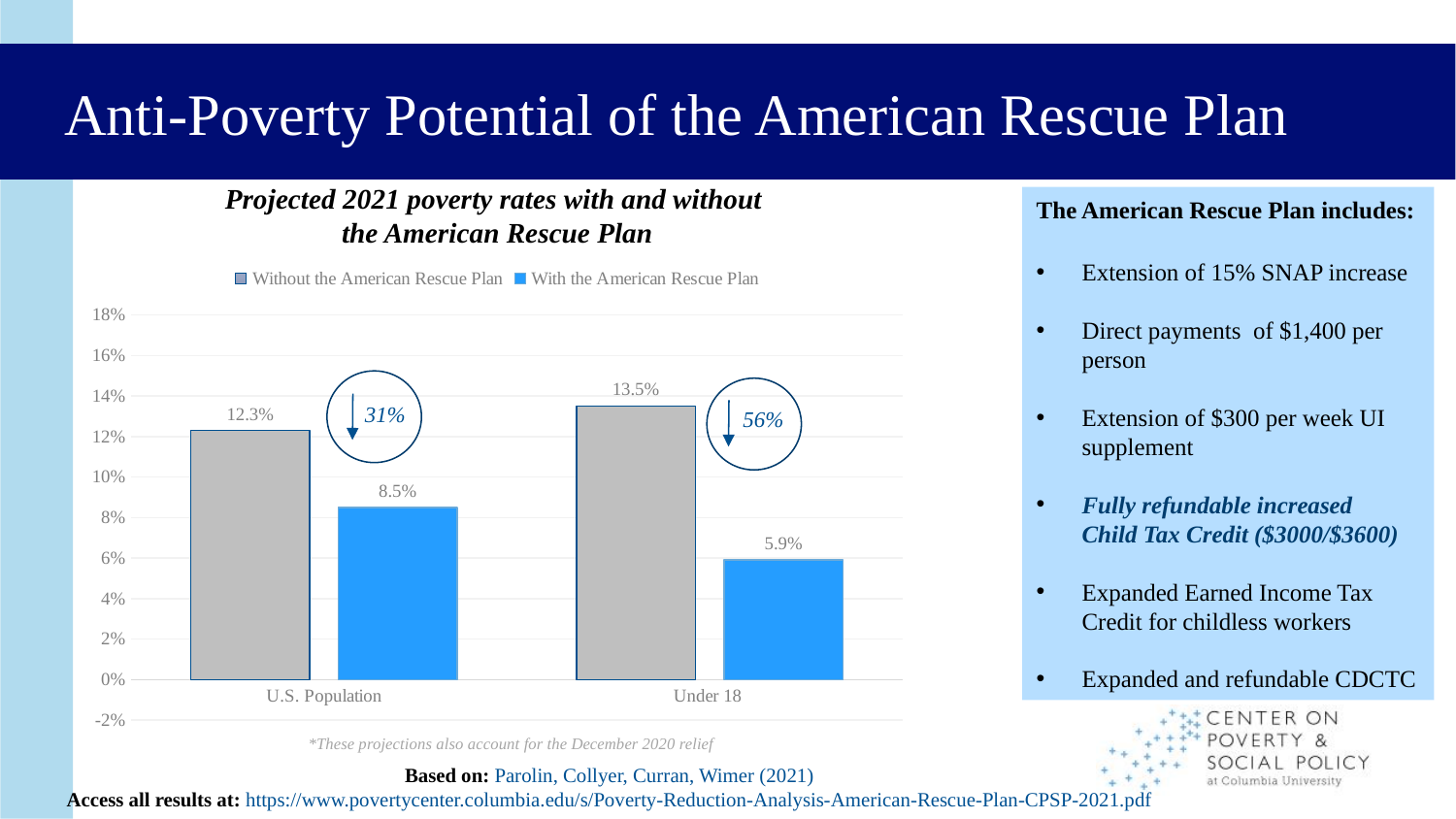
What is the projected 2021 poverty rate for Under 18 without the American Rescue Plan? 13.5% How many series does the chart legend list? 2 What kind of chart is shown on the slide? Bar chart What is the projected 2021 poverty rate for Under 18 with the American Rescue Plan? 5.9% How many categories are shown on the x axis of the chart? 2 Which category has the highest projected poverty rate without the American Rescue Plan? Under 18 What is the projected 2021 poverty rate for the U.S. Population with the American Rescue Plan? 8.5% What is the difference between the Under 18 poverty rate without and with the American Rescue Plan? 7.6% Which is larger: the U.S. Population rate with the American Rescue Plan or the Under 18 rate with the American Rescue Plan? U.S. Population rate with the American Rescue Plan Which bar shows the lowest projected poverty rate on the chart? Under 18 with the American Rescue Plan What is the projected 2021 poverty rate for the U.S. Population without the American Rescue Plan? 12.3% What percentage reduction is shown in the circle for the Under 18 category? 56%